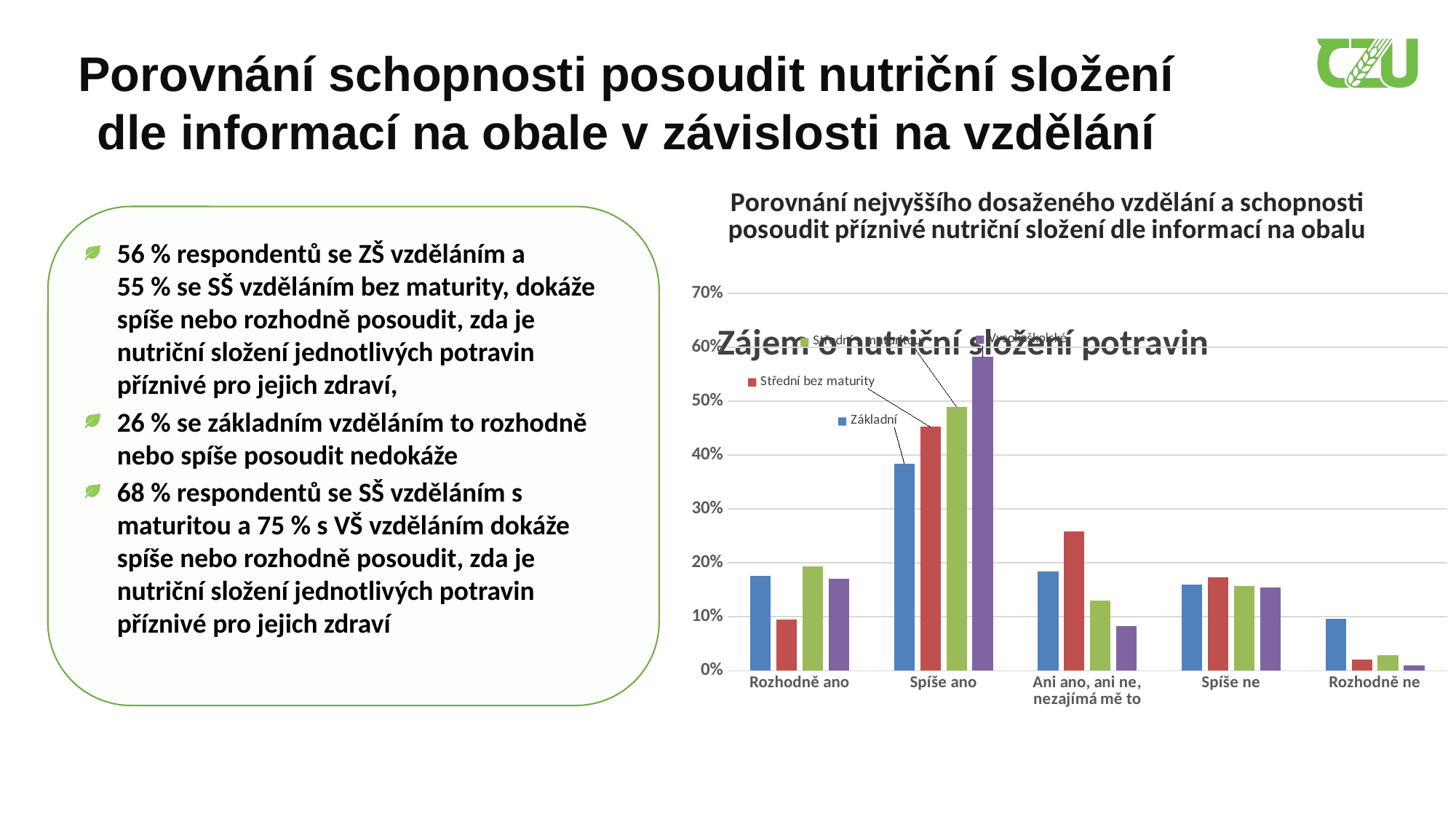
In the Rozhodně ne category, which is larger: the value for Základní or the value for Střední bez maturity? Základní What is the title of the chart? Porovnání nejvyššího dosaženého vzdělání a schopnosti posoudit příznivé nutriční složení dle informací na obalu How many series does the chart's legend list? 4 Is the value for Vysokoškolské in the Spíše ano category greater or less than 50%? greater What kind of chart is shown on the slide? bar chart In the Ani ano, ani ne, nezajímá mě to category, which series has the highest value? Střední bez maturity Which category has the lowest value for the Vysokoškolské series? Rozhodně ne Which category has the highest value for the Vysokoškolské series? Spíše ano Is the value for Základní in the Spíše ano category greater or less than 40%? less How many categories are shown on the x axis of the chart? 5 In the Spíše ano category, which is larger: the value for Střední bez maturity or the value for Vysokoškolské? Vysokoškolské